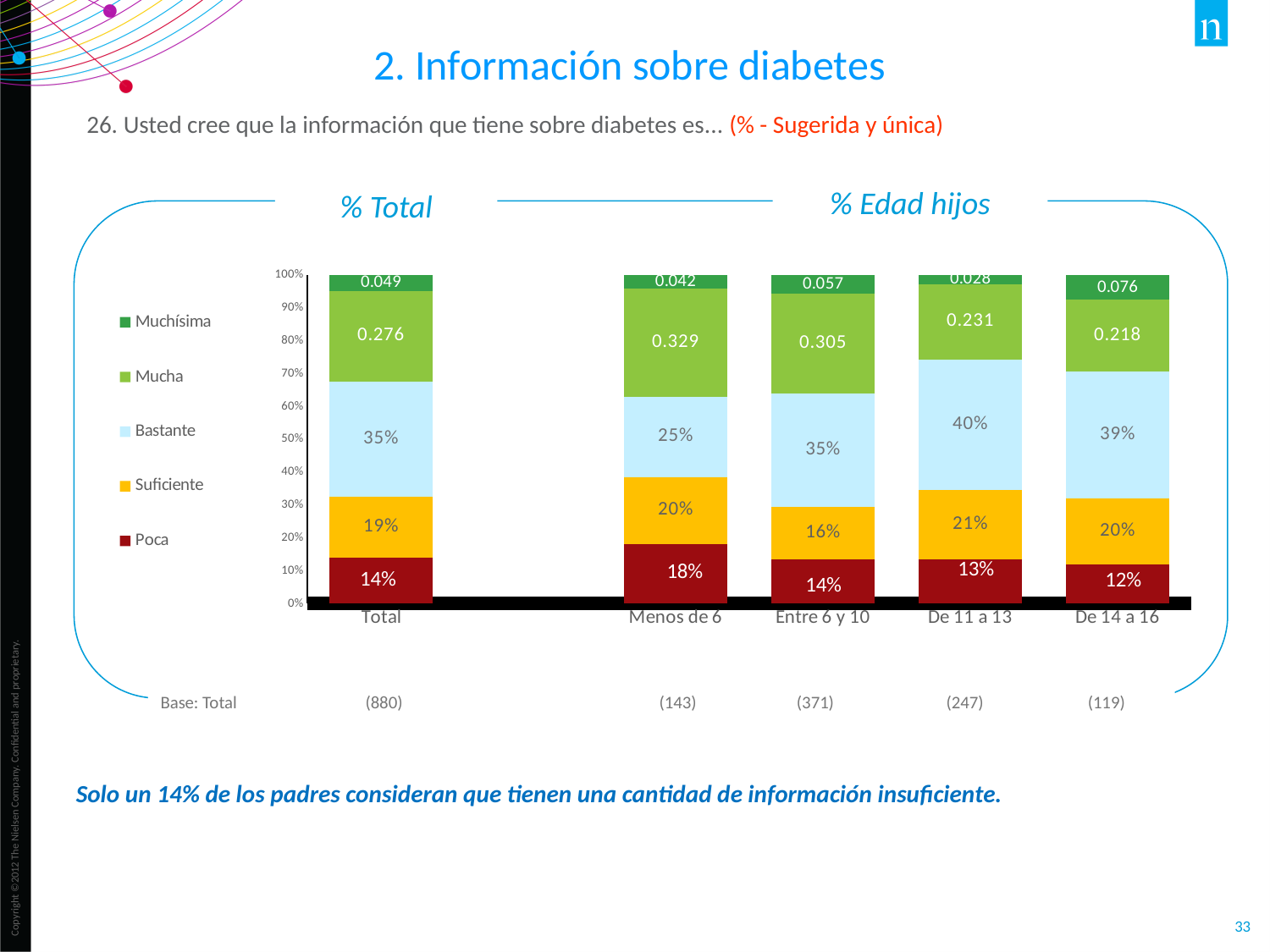
Which legend entry is shown in dark red? Poca How many categories are shown along the x axis? 5 What is the difference between the Poca value for Menos de 6 and the Poca value for De 14 a 16? 6% What is the value of Poca for the Total category? 14% What kind of chart is shown on the slide? stacked bar chart Which category has the lowest value for Bastante? Menos de 6 What is the value of Mucha for Menos de 6? 0.329 Which is larger: the Suficiente value for De 11 a 13 or the Suficiente value for Entre 6 y 10? De 11 a 13 What is the value of Muchísima for De 14 a 16? 0.076 How many series does the legend list? 5 What is the value of Bastante for De 11 a 13? 40% Which category has the highest value for Poca? Menos de 6